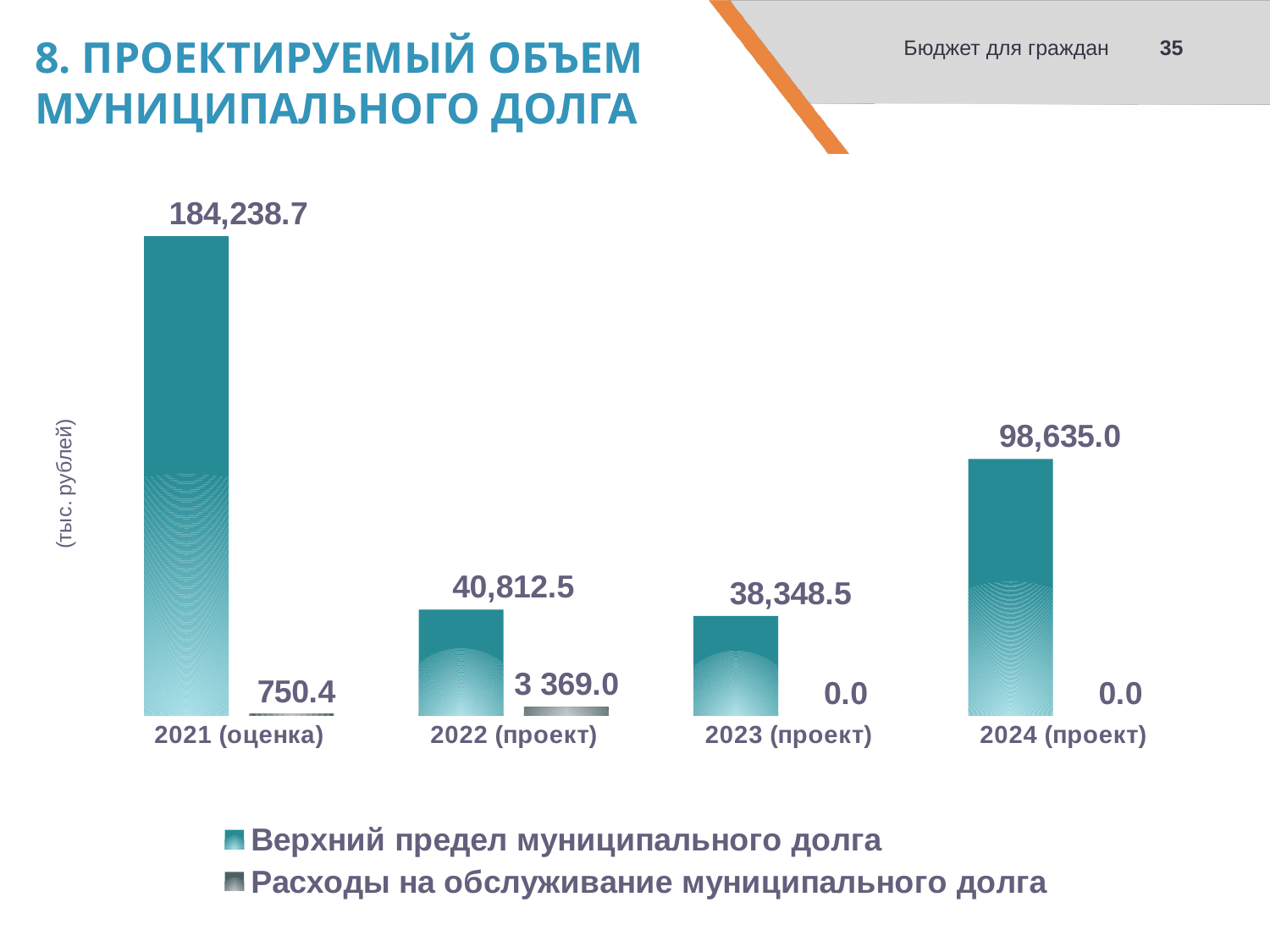
What kind of chart is shown on the slide? Bar chart Which is larger: 'Верхний предел муниципального долга' for 2024 (проект) or for 2022 (проект)? 2024 (проект) What is the value of 'Верхний предел муниципального долга' for 2024 (проект)? 98,635.0 How many years (categories) are shown on the x axis? 4 What is the value of 'Расходы на обслуживание муниципального долга' for 2022 (проект)? 3 369.0 What unit is shown on the vertical axis label? тыс. рублей Which year has the lowest value of 'Верхний предел муниципального долга'? 2023 (проект) How many series does the legend list? 2 What is the value of 'Расходы на обслуживание муниципального долга' for 2021 (оценка)? 750.4 What is the difference between the 'Верхний предел муниципального долга' values for 2022 (проект) and 2023 (проект)? 2,464.0 Which year has the highest value of 'Верхний предел муниципального долга'? 2021 (оценка) What is the value of 'Верхний предел муниципального долга' for 2021 (оценка)? 184,238.7